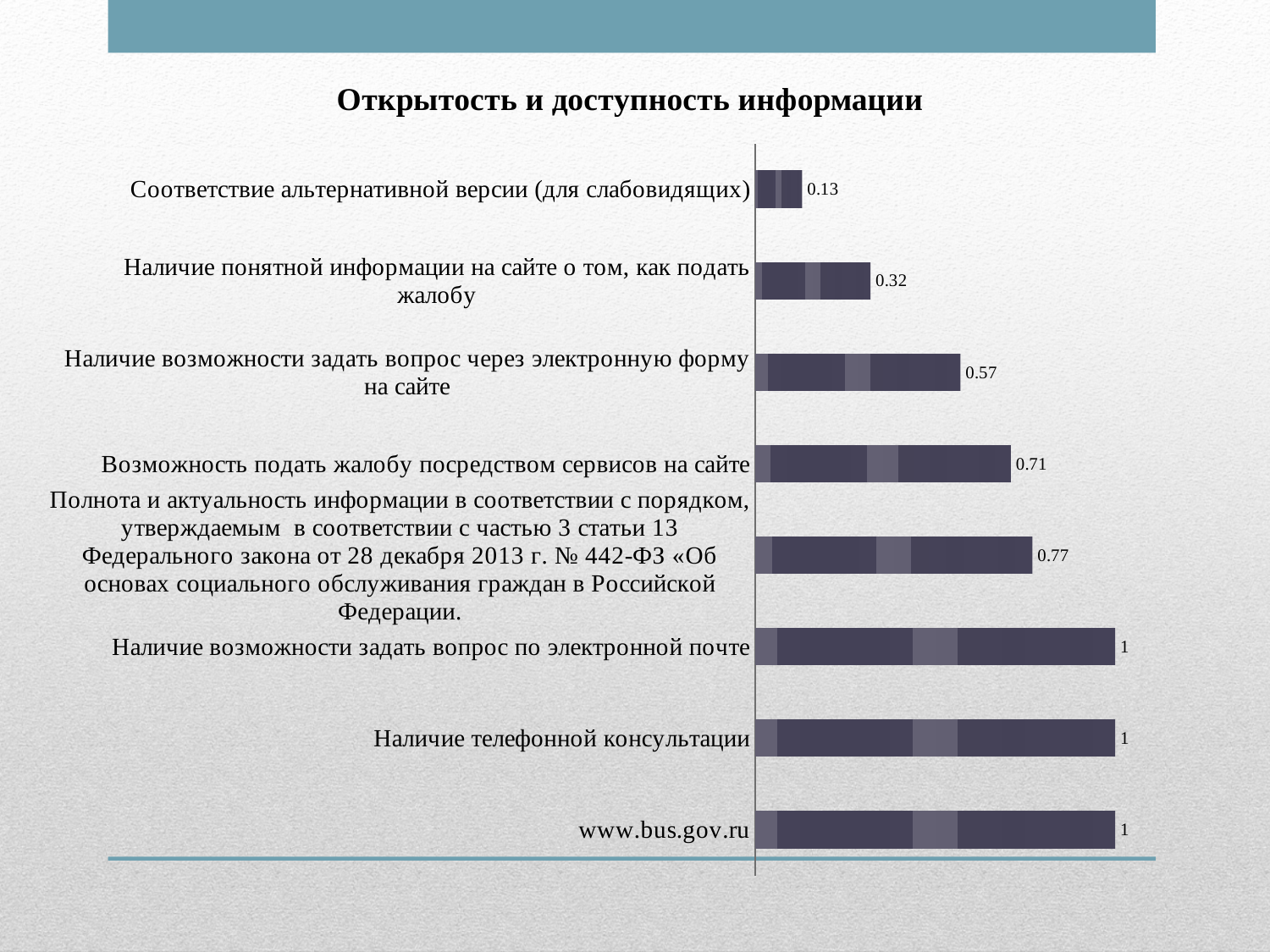
How many categories have a value of 1? 3 What is the value for "Соответствие альтернативной версии (для слабовидящих)"? 0.13 What is the title of the chart? Открытость и доступность информации What is the value for "Возможность подать жалобу посредством сервисов на сайте"? 0.71 What is the difference between the values for "Возможность подать жалобу посредством сервисов на сайте" and "Наличие понятной информации на сайте о том, как подать жалобу"? 0.39 Which is larger: the value for "Наличие возможности задать вопрос через электронную форму на сайте" or the value for "Соответствие альтернативной версии (для слабовидящих)"? Наличие возможности задать вопрос через электронную форму на сайте What kind of chart is shown on the slide? Bar chart What is the value for "Наличие возможности задать вопрос через электронную форму на сайте"? 0.57 How many categories are shown in the chart? 8 Which category has the lowest value? Соответствие альтернативной версии (для слабовидящих) What is the value for "Наличие телефонной консультации"? 1 What is the value for "Наличие понятной информации на сайте о том, как подать жалобу"? 0.32